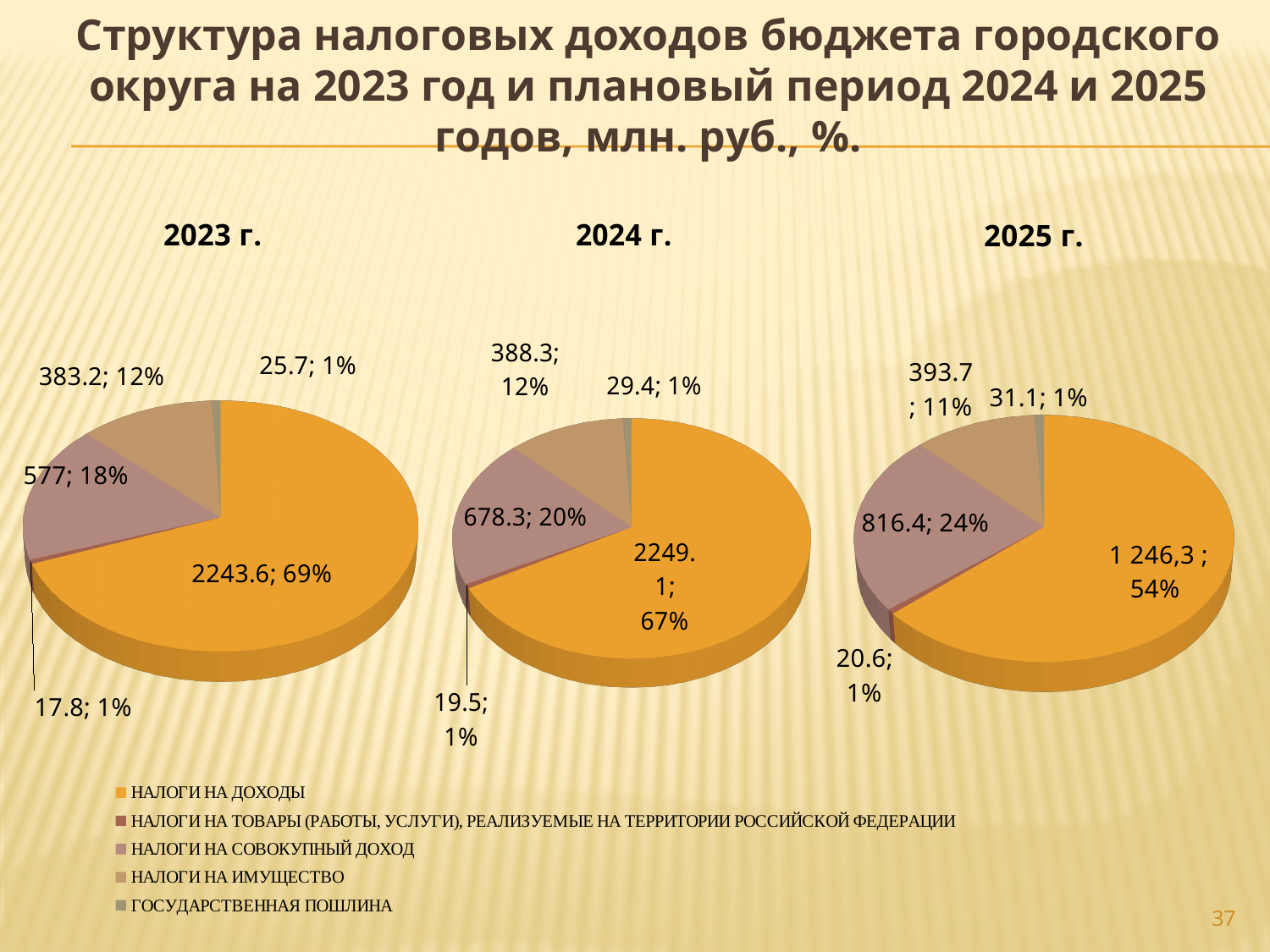
In the 2023 г. chart, which category has the largest slice? НАЛОГИ НА ДОХОДЫ What kind of charts are shown on the slide? Pie charts In the 2024 г. chart, what is the value for НАЛОГИ НА СОВОКУПНЫЙ ДОХОД? 678.3 In the 2025 г. chart, what share of the pie does НАЛОГИ НА ДОХОДЫ take? 54% In the 2025 г. chart, what is the value for НАЛОГИ НА ИМУЩЕСТВО? 393.7 How many slices does the 2025 г. pie chart have? 5 In the 2023 г. chart, what is the value and share for НАЛОГИ НА ДОХОДЫ? 2243.6; 69% Which is larger: the value for НАЛОГИ НА СОВОКУПНЫЙ ДОХОД in the 2024 г. chart or in the 2025 г. chart? 2025 г. How many series does the legend list? 5 In the 2023 г. chart, what is the difference between the values for НАЛОГИ НА СОВОКУПНЫЙ ДОХОД and НАЛОГИ НА ИМУЩЕСТВО? 193.8 In the 2024 г. chart, which category has the smallest value? НАЛОГИ НА ТОВАРЫ (РАБОТЫ, УСЛУГИ), РЕАЛИЗУЕМЫЕ НА ТЕРРИТОРИИ РОССИЙСКОЙ ФЕДЕРАЦИИ In the 2024 г. chart, what is the value and share for ГОСУДАРСТВЕННАЯ ПОШЛИНА? 29.4; 1%